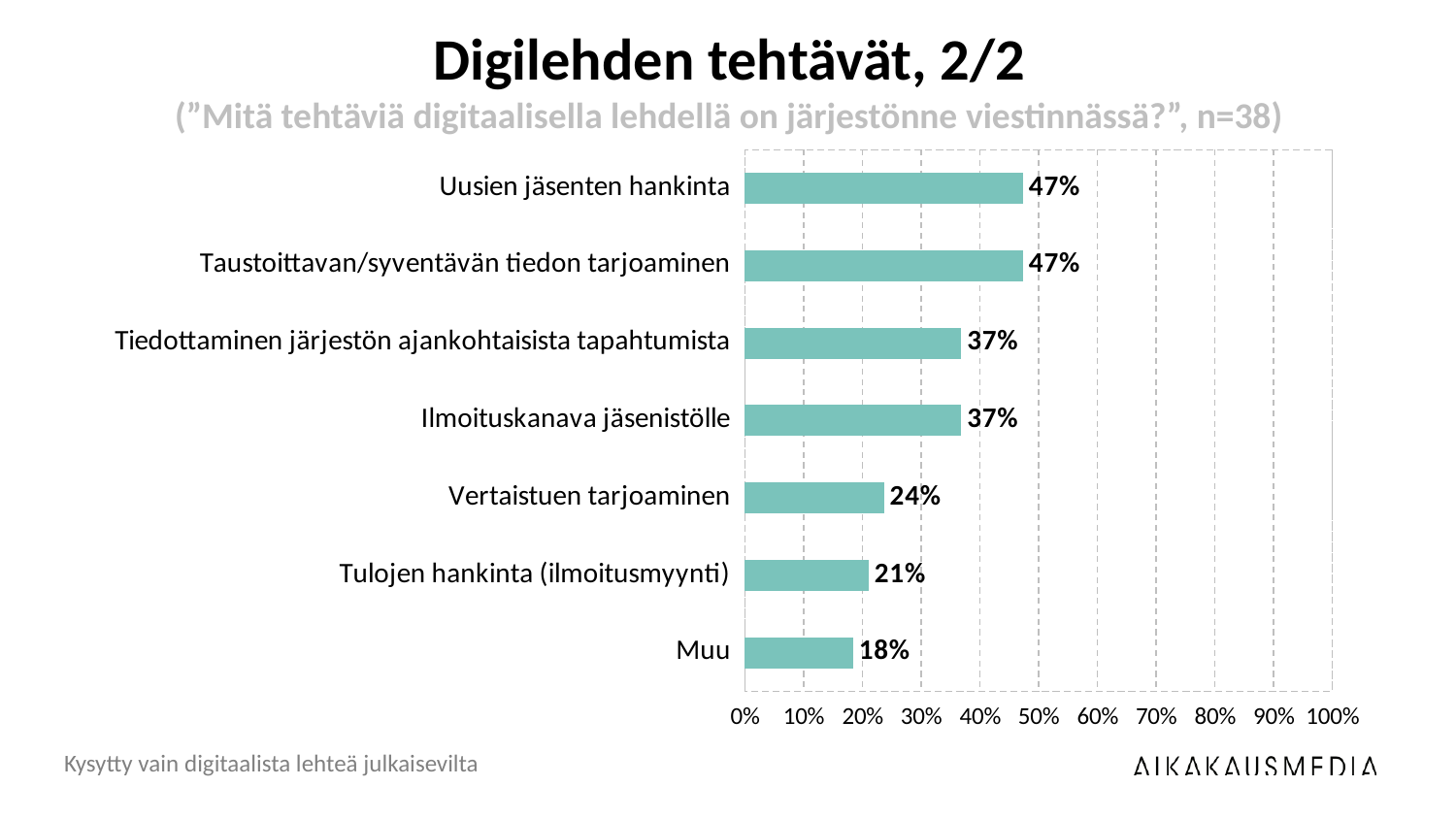
What is the value for "Muu"? 18% What is the difference between the values for "Uusien jäsenten hankinta" and "Muu"? 29% What is the value for "Tulojen hankinta (ilmoitusmyynti)"? 21% How many categories are shown in the chart? 7 What is the value for "Ilmoituskanava jäsenistölle"? 37% What is the difference between the values for "Tiedottaminen järjestön ajankohtaisista tapahtumista" and "Vertaistuen tarjoaminen"? 13% Is the value for "Taustoittavan/syventävän tiedon tarjoaminen" greater or less than 40%? greater What is the value for "Vertaistuen tarjoaminen"? 24% What kind of chart is shown on the slide? bar chart Which is larger: the value for "Vertaistuen tarjoaminen" or the value for "Tulojen hankinta (ilmoitusmyynti)"? Vertaistuen tarjoaminen Which category has the lowest value? Muu What is the title of the chart? Digilehden tehtävät, 2/2